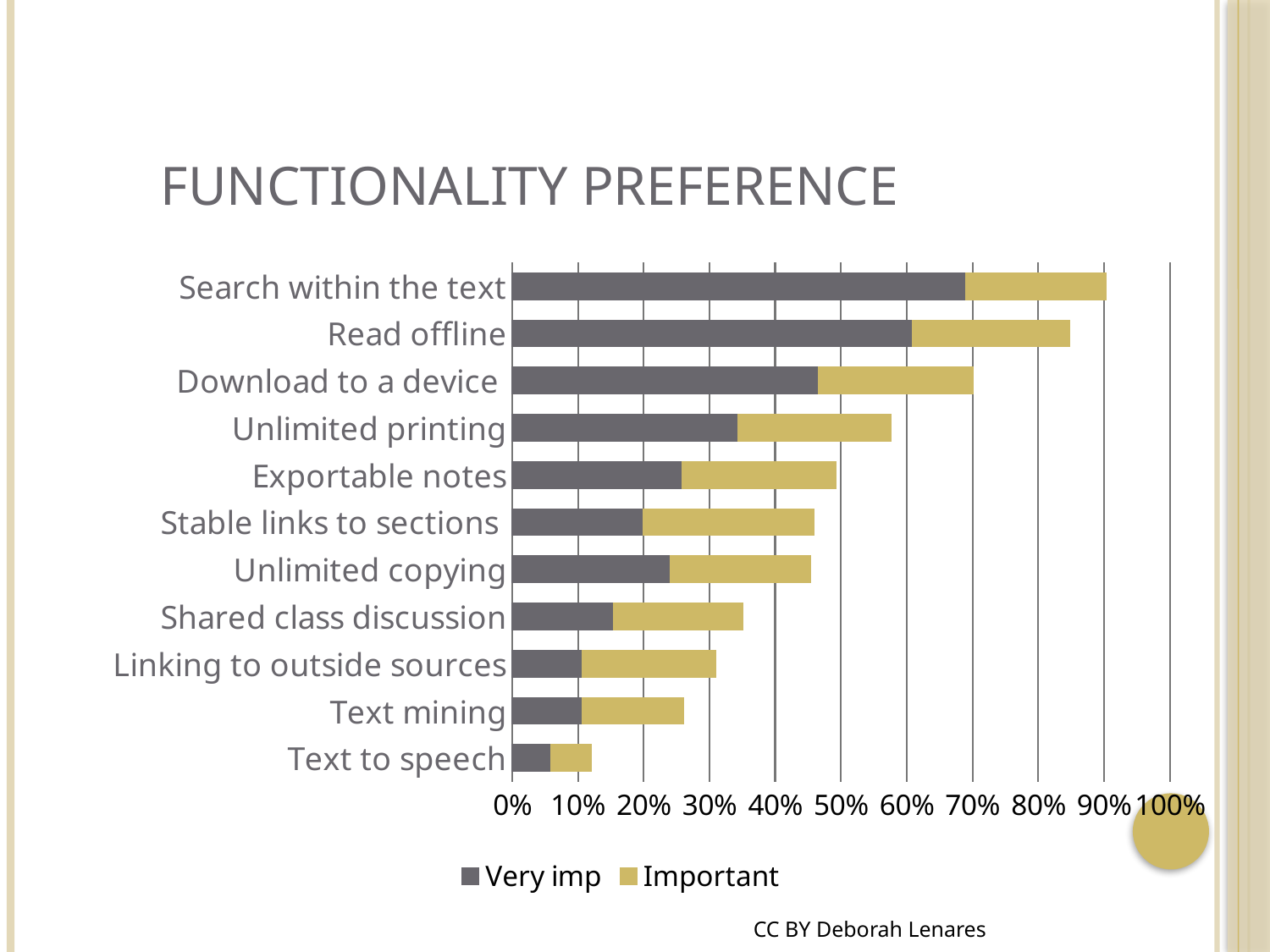
Which has a longer total bar, Read offline or Download to a device? Read offline Is the total bar for Download to a device greater or less than 60%? greater Is the total bar for Shared class discussion greater or less than 40%? less Which category has the shortest total bar? Text to speech What is the title of the chart on the slide? Functionality Preference Do the total bar lengths decrease from the top category to the bottom category? Yes How many series does the legend list? 2 What kind of chart is shown on the slide? Stacked bar chart How many functionality categories are plotted in the chart? 11 Which category has the longest total bar? Search within the text Is the Very imp value for Search within the text greater or less than 60%? greater